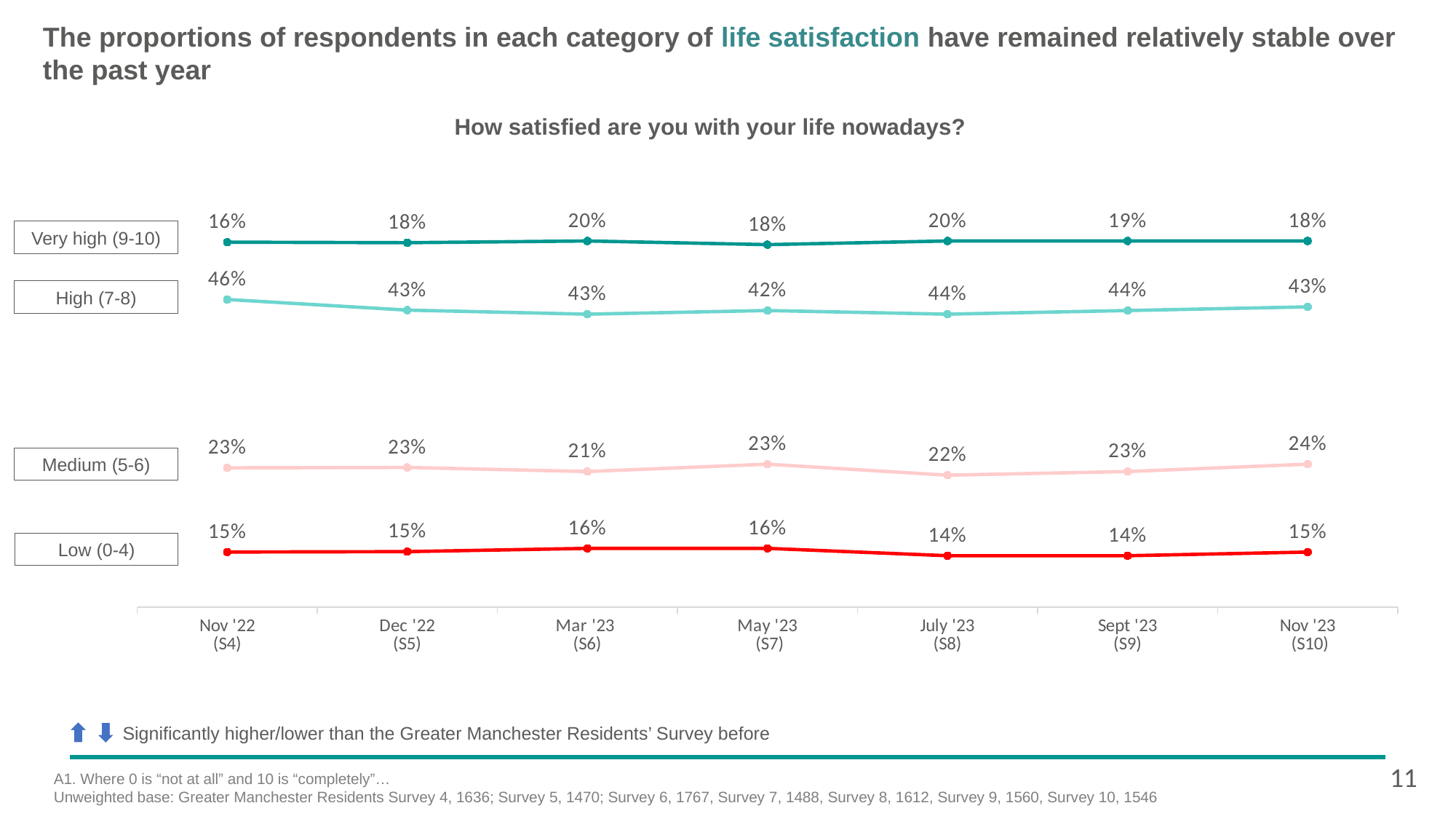
What is the difference between the High (7-8) and Very high (9-10) proportions in Nov '23 (S10)? 25 percentage points What percentage of respondents reported High (7-8) life satisfaction in Nov '22 (S4)? 46% In which survey wave was the Medium (5-6) proportion at its lowest? Mar '23 (S6) In which survey wave was the High (7-8) proportion at its highest? Nov '22 (S4) What percentage of respondents reported Medium (5-6) life satisfaction in Nov '23 (S10)? 24% What percentage of respondents reported Low (0-4) life satisfaction in July '23 (S8)? 14% Which was larger in May '23 (S7): the Medium (5-6) proportion or the Very high (9-10) proportion? Medium (5-6) What percentage of respondents reported Very high (9-10) life satisfaction in Mar '23 (S6)? 20% What type of chart is used to show the life satisfaction proportions? Line chart How many survey waves are plotted on the x axis? 7 How many life satisfaction categories (series) are plotted on the chart? 4 What is the title of the chart? How satisfied are you with your life nowadays?